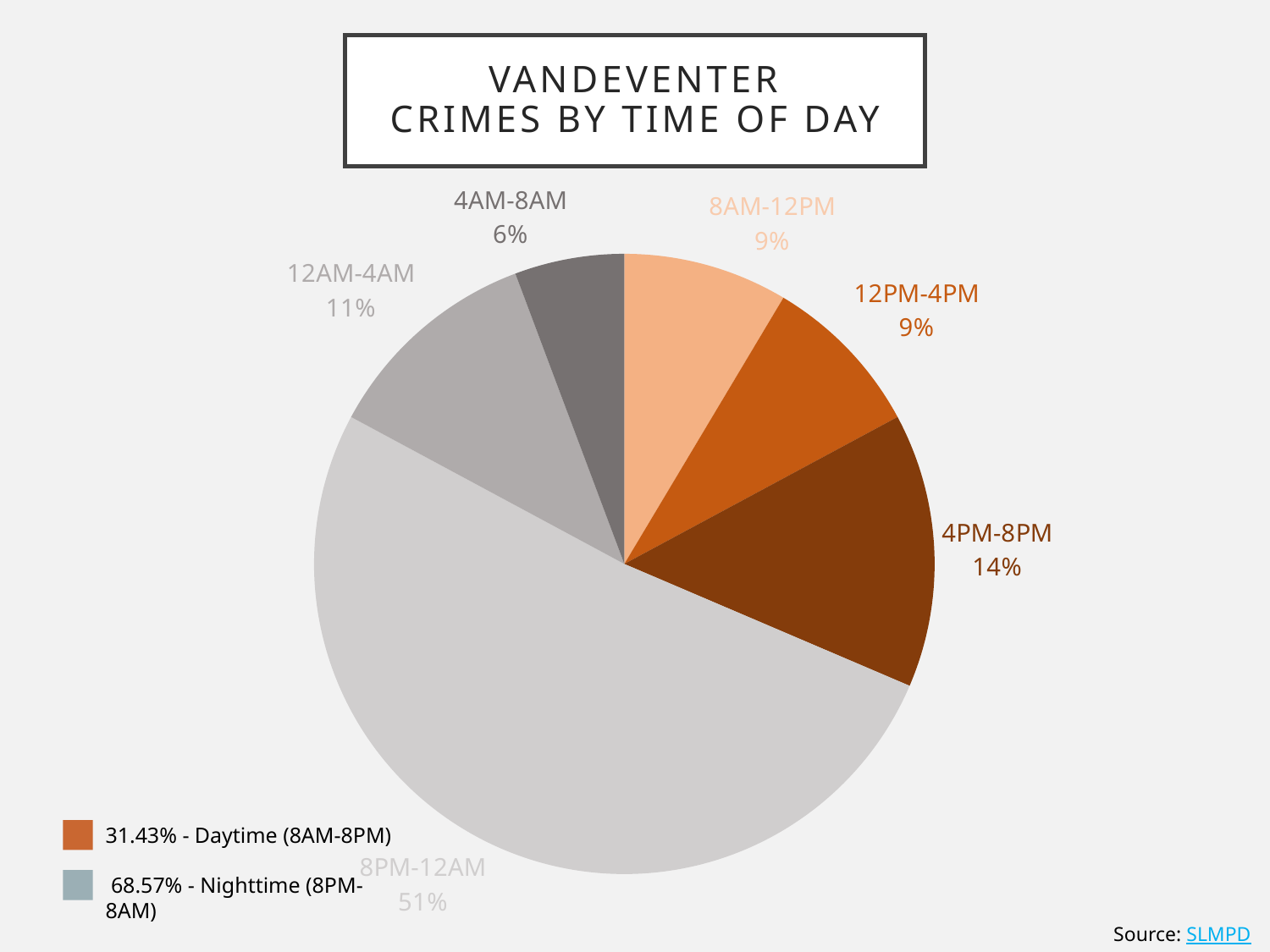
What is the title of the chart? Vandeventer Crimes by Time of Day How many time-of-day slices does the pie chart have? 6 What is the difference in percentage points between the 8PM-12AM slice and the 4PM-8PM slice? 37 Which time-of-day slice is the largest? 8PM-12AM According to the legend, what percentage of crimes occurred during nighttime (8PM-8AM)? 68.57% Which time-of-day slice is the smallest? 4AM-8AM What share of crimes occurred between 4PM and 8PM? 14% What share of crimes occurred between 12AM and 4AM? 11% What kind of chart is shown on the slide? pie chart What share of crimes occurred between 4AM and 8AM? 6% Which slice is larger, 12AM-4AM or 4AM-8AM? 12AM-4AM What share of crimes occurred between 8PM and 12AM? 51%